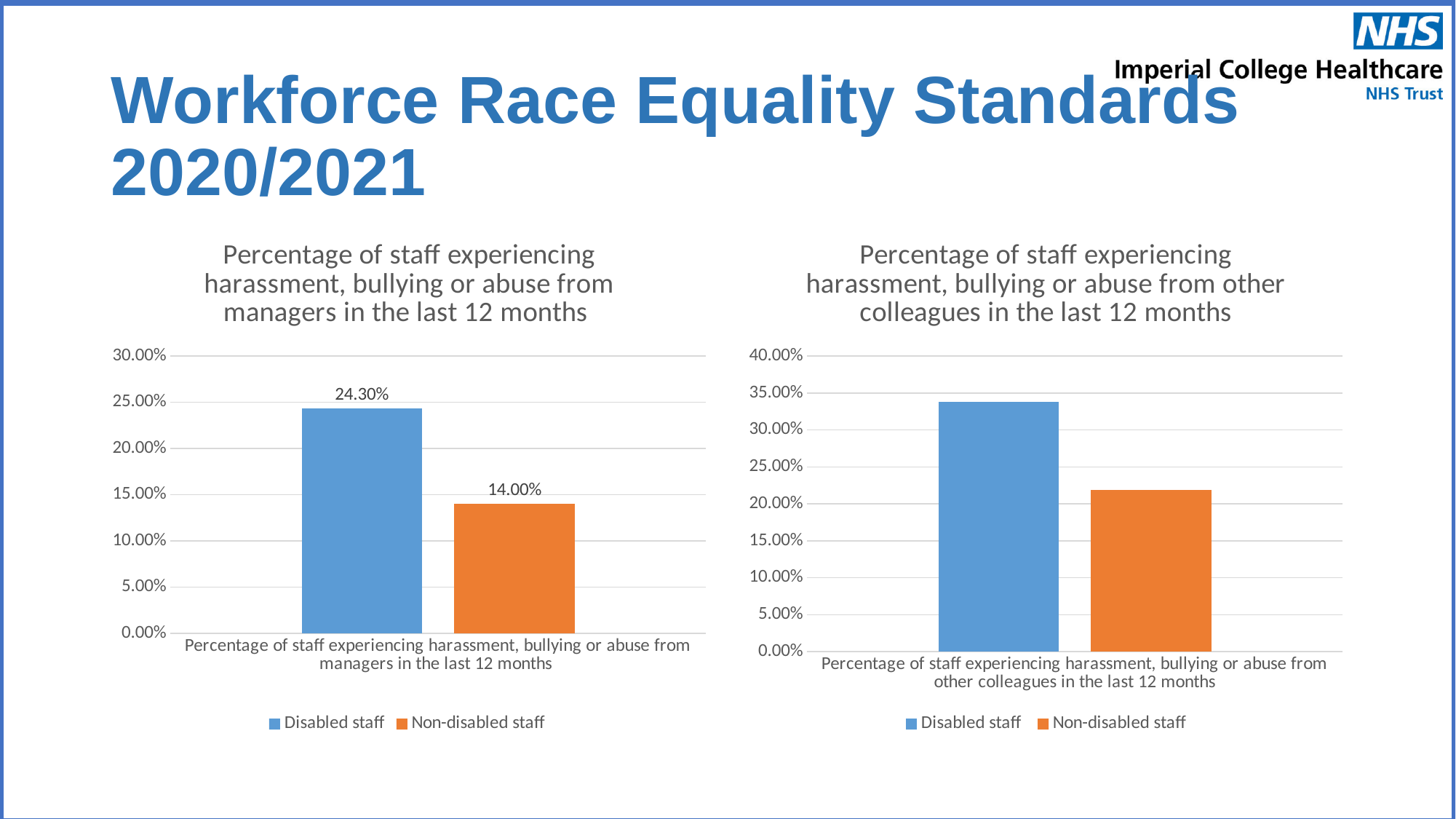
In the right chart (harassment from other colleagues), is the value for Disabled staff greater or less than 30.00%? greater In the left chart (harassment from managers), what is the value for Disabled staff? 24.30% How many series does the legend of the left chart list? 2 In the left chart, which colour represents Non-disabled staff? Orange In the right chart (harassment from other colleagues), is the value for Non-disabled staff greater or less than 25.00%? less In the right chart (harassment from other colleagues), which series has the lower value? Non-disabled staff In the left chart (harassment from managers), what is the value for Non-disabled staff? 14.00% What kind of chart is the right chart (harassment from other colleagues)? Bar chart In the right chart (harassment from other colleagues), is the value for Non-disabled staff greater or less than 20.00%? greater In the left chart (harassment from managers), what is the difference between the Disabled staff and Non-disabled staff values? 10.30% What is the highest value shown on the y axis of the right chart? 40.00% In the left chart (harassment from managers), which series has the higher value? Disabled staff